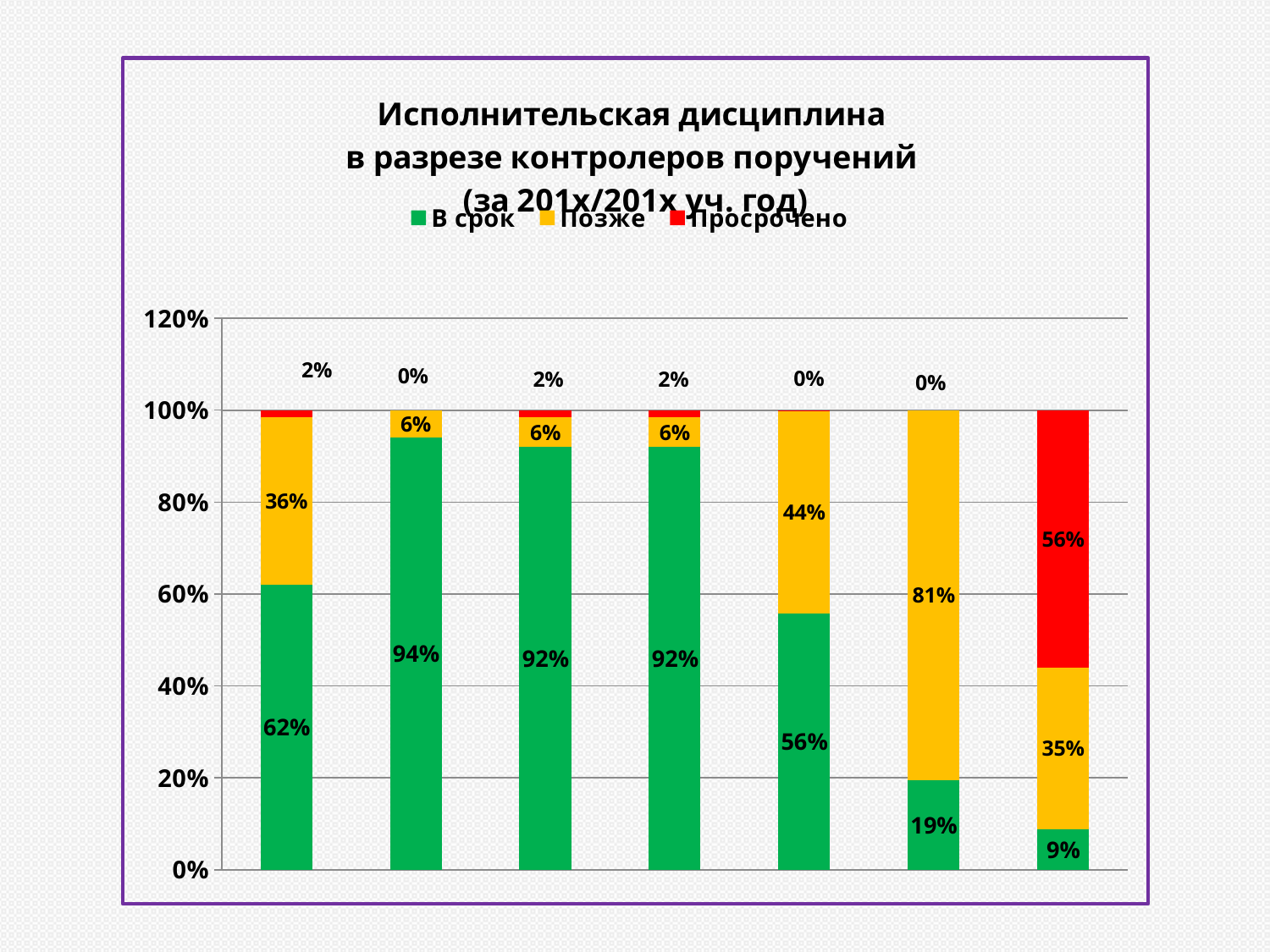
How many series does the legend list? 3 Which bar has the lowest "В срок" value? the rightmost bar (9%) What is the difference between the "Позже" values of the sixth bar and the fifth bar from the left? 37% How many bars are plotted in the chart? 7 What kind of chart is shown on the slide? stacked bar chart What is the first line of the chart title? Исполнительская дисциплина Which series is shown in red in the legend? Просрочено What is the value of the "Позже" segment for the sixth bar from the left? 81% Which is larger: the "В срок" value of the first bar or the "В срок" value of the fifth bar from the left? the first bar (62%) What is the value of the "В срок" segment for the first bar from the left? 62% What is the value of the "Просрочено" segment for the rightmost bar? 56% Which bar has the highest "В срок" value? the second bar from the left (94%)